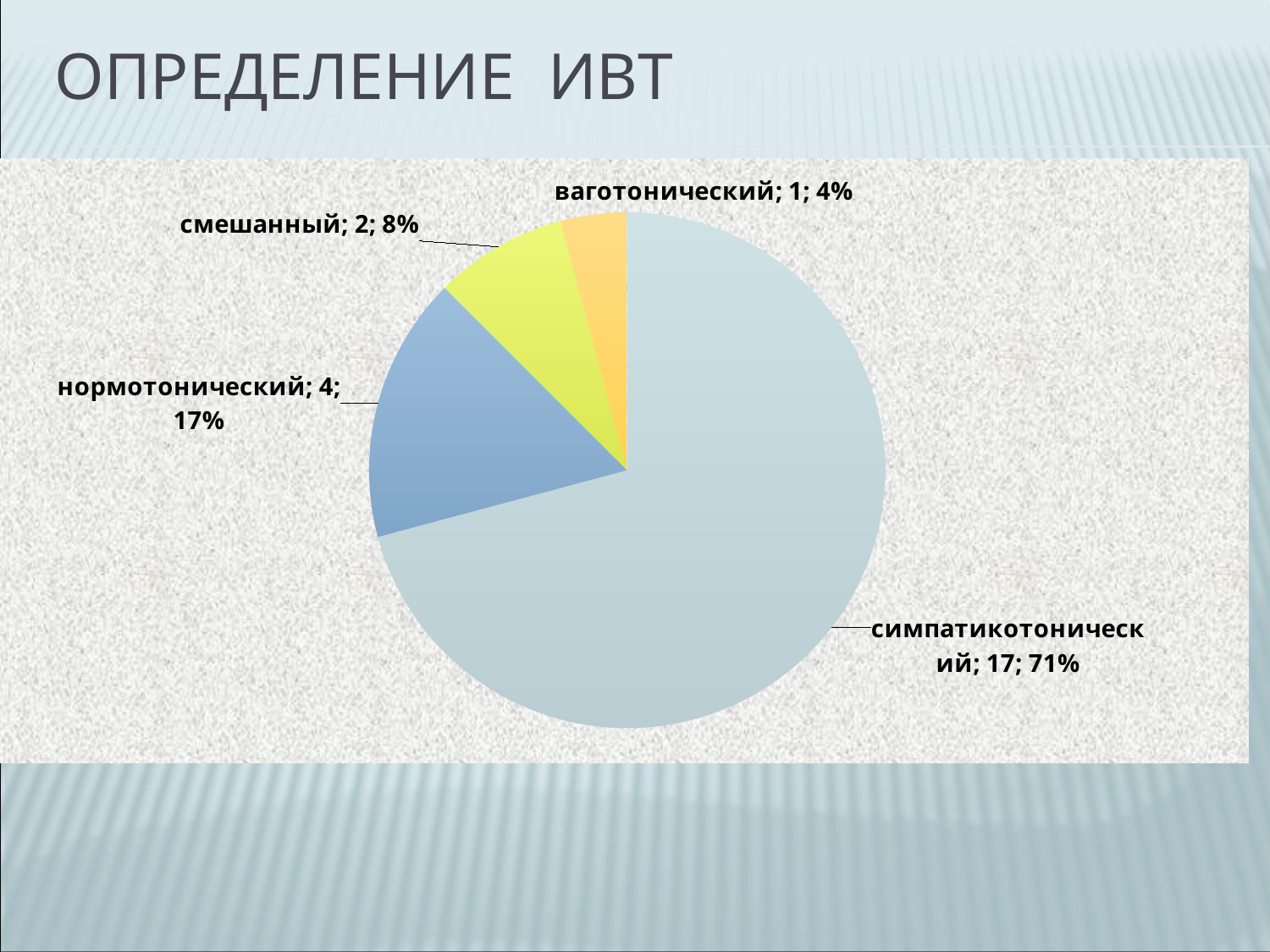
What is the value for ваготонический? 1 What kind of chart is shown on the slide? pie chart What share of the pie does нормотонический take? 17% What share of the pie does симпатикотонический take? 71% What is the difference between the values for симпатикотонический and нормотонический? 13 What is the value for смешанный? 2 What is the value for симпатикотонический? 17 Which category has the largest slice? симпатикотонический Which is larger, the value for смешанный or the value for ваготонический? смешанный How many slices does the pie chart have? 4 What is the value for нормотонический? 4 Which category has the smallest slice? ваготонический